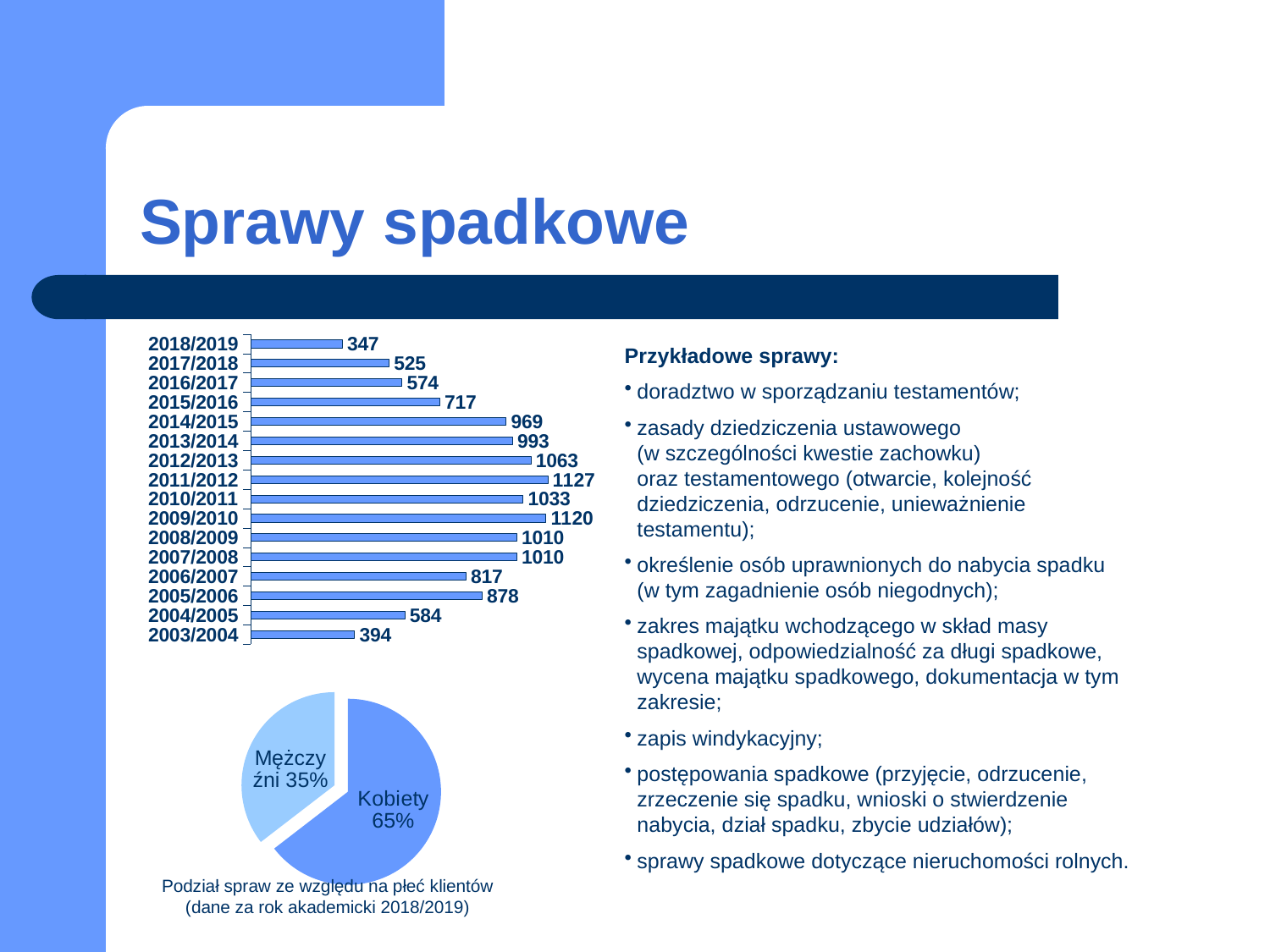
In the bar chart at the top left, what is the difference between the values for 2011/2012 and 2018/2019? 780 In the bar chart at the top left, what is the value for 2018/2019? 347 In the bar chart at the top left, which academic year has the lowest value? 2018/2019 In the bar chart at the top left, what is the value for 2003/2004? 394 In the bar chart at the top left, which academic year has the highest value? 2011/2012 In the bar chart at the top left, how many academic years are shown? 16 In the pie chart at the bottom left, what share is labelled Mężczyźni? 35% In the bar chart at the top left, do the values rise or fall from 2014/2015 to 2018/2019? fall In the pie chart at the bottom left, what share is labelled Kobiety? 65% In the bar chart at the top left, what is the value for 2009/2010? 1120 What kind of chart is the chart at the top left of the slide? bar chart In the bar chart at the top left, which is larger, the value for 2005/2006 or the value for 2006/2007? 2005/2006